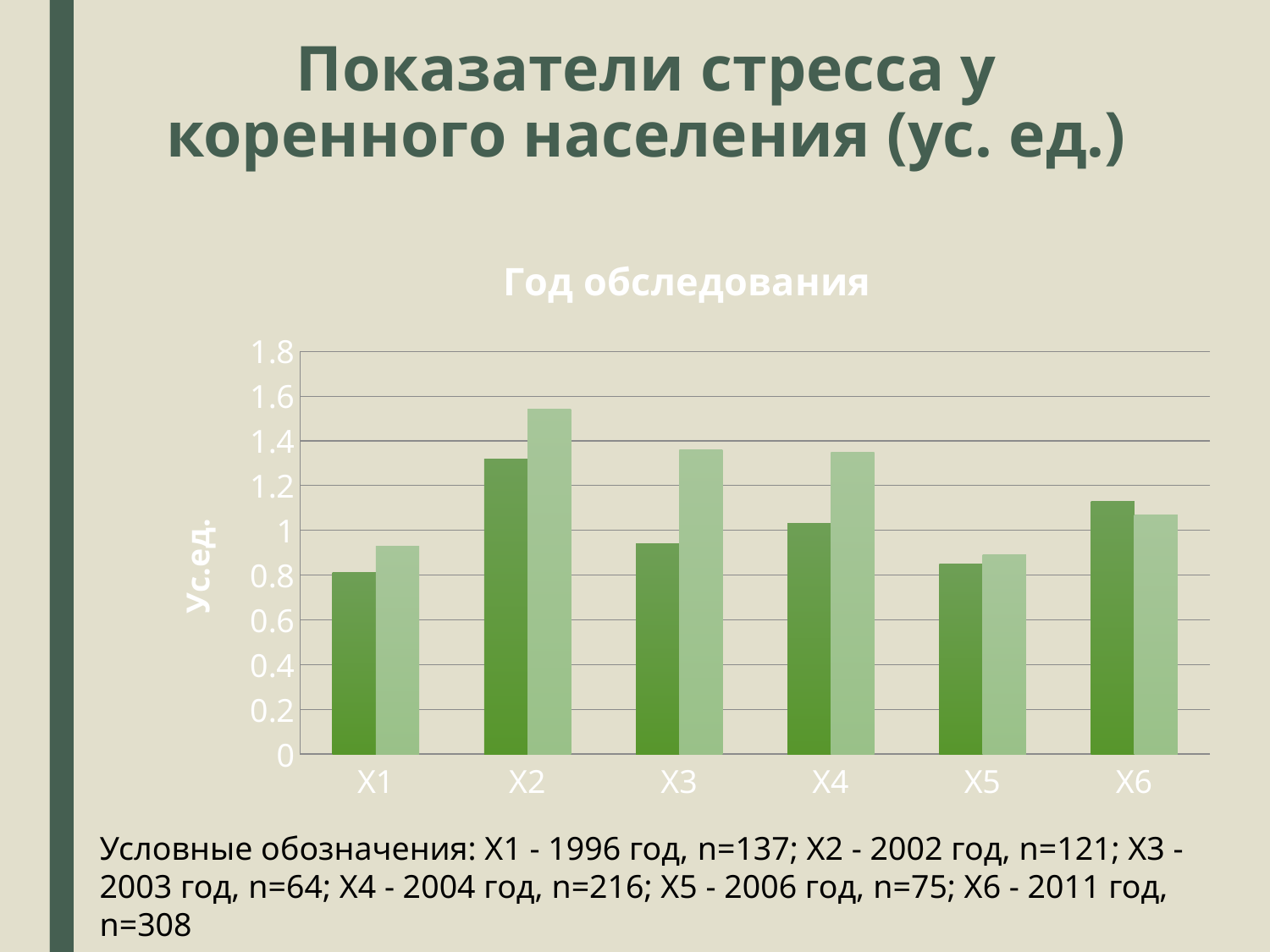
Which category has the tallest bar in the chart? X2 Which is larger, the dark green bar for X2 or the dark green bar for X4? X2 Which category has the shortest bar in the chart? X1 How many categories are shown on the x axis of the chart? 6 Is the value of the dark green bar for X6 greater or less than 1? greater What kind of chart is shown on the slide? bar chart Which is larger, the light green bar for X3 or the light green bar for X5? X3 Is the value of the light green bar for X2 greater or less than 1.4? greater What is the label on the vertical axis of the chart? Ус.ед. Is the value of the dark green bar for X5 greater or less than 1? less What is the title printed above the chart? Год обследования